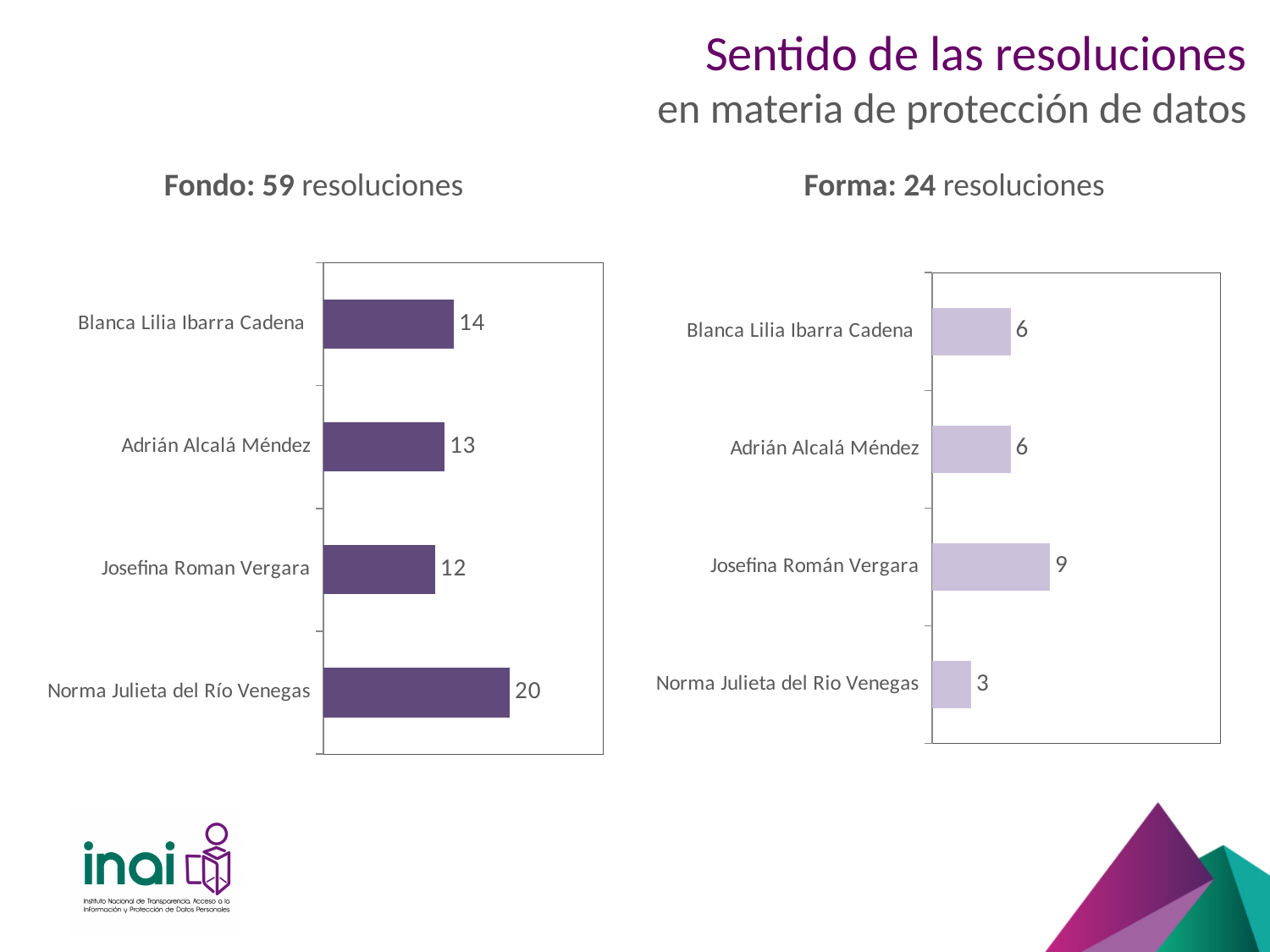
In the Fondo chart, what is the difference between the values for Norma Julieta del Río Venegas and Josefina Roman Vergara? 8 In the Fondo chart, which is larger: the value for Blanca Lilia Ibarra Cadena or Adrián Alcalá Méndez? Blanca Lilia Ibarra Cadena How many categories does the Fondo chart show? 4 In the Fondo chart, which category has the highest value? Norma Julieta del Río Venegas In the Forma chart, what is the value for Josefina Román Vergara? 9 In the Forma chart, what is the difference between the values for Josefina Román Vergara and Norma Julieta del Rio Venegas? 6 What kind of chart is the Forma chart? Bar chart In the Forma chart, which category has the lowest value? Norma Julieta del Rio Venegas In the Fondo chart, what is the value for Norma Julieta del Río Venegas? 20 How many resoluciones does the Forma heading state in total? 24 In the Forma chart, which is larger: the value for Josefina Román Vergara or Blanca Lilia Ibarra Cadena? Josefina Román Vergara In the Fondo chart, what is the value for Adrián Alcalá Méndez? 13